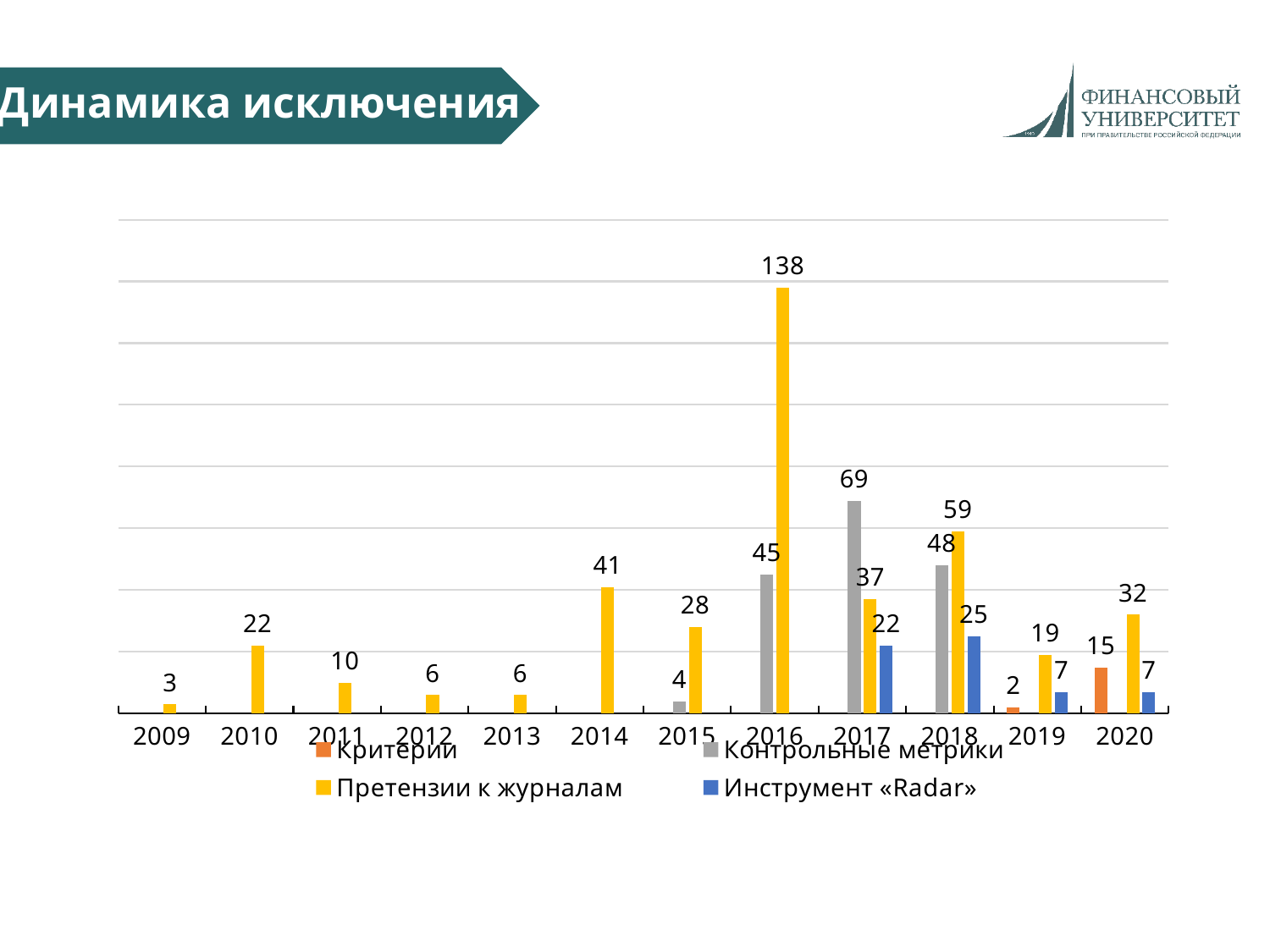
What is the value of Критерии in 2020? 15 How many years are shown on the x axis? 12 What is the difference between Претензии к журналам in 2016 and in 2017? 101 What is the value of Инструмент «Radar» in 2018? 25 What is the value of Контрольные метрики in 2017? 69 How many series does the legend list? 4 In which year is Претензии к журналам highest? 2016 What is the value of Претензии к журналам in 2016? 138 What kind of chart is shown on the slide? bar chart Which is larger in 2018: Контрольные метрики or Претензии к журналам? Претензии к журналам What is the title of the slide containing the chart? Динамика исключения In which year is Претензии к журналам lowest? 2009